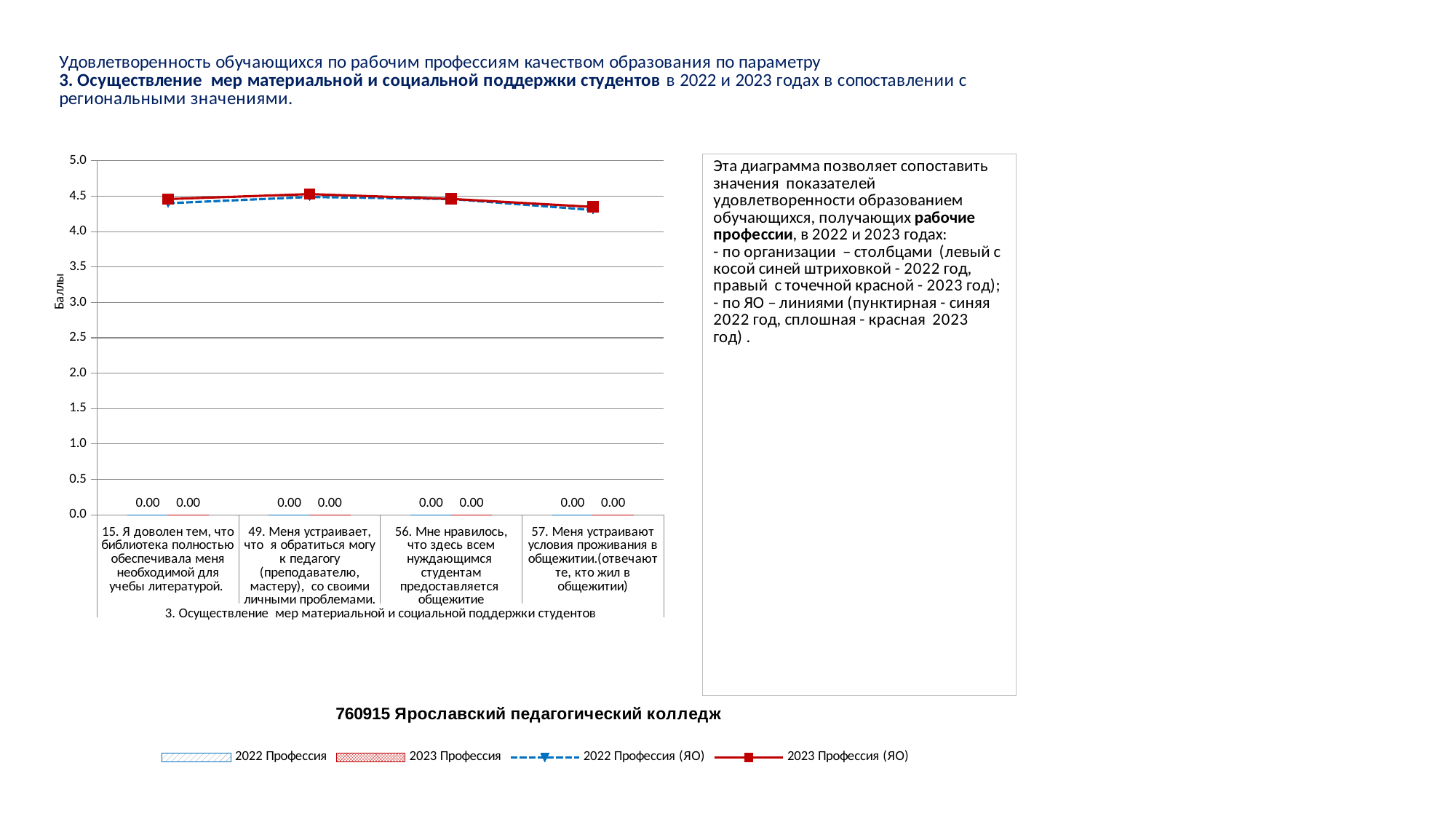
Is the value of the 2023 Профессия (ЯО) line for category 49 greater or less than 4.0? greater How many series does the legend list? 4 What is the value of the 2023 Профессия bar for category "57. Меня устраивают условия проживания в общежитии"? 0.00 Does the 2023 Профессия (ЯО) line rise or fall from category 49 to category 57? falls What kind of chart is shown on the slide? Combined bar and line chart How many categories are shown on the x axis of the chart? 4 What is the value of the 2022 Профессия bar for category "15. Я доволен тем, что библиотека полностью обеспечивала меня необходимой для учебы литературой."? 0.00 Which is larger for the 2023 Профессия (ЯО) line: the value for category 49 or the value for category 57? Category 49 Is the value of the 2022 Профессия (ЯО) line for category 57 greater or less than 4.5? less What is the label of the vertical axis of the chart? Баллы For which category is the 2023 Профессия (ЯО) line lowest? 57. Меня устраивают условия проживания в общежитии.(отвечают те, кто жил в общежитии) For which category is the 2023 Профессия (ЯО) line highest? 49. Меня устраивает, что я обратиться могу к педагогу (преподавателю, мастеру), со своими личными проблемами.